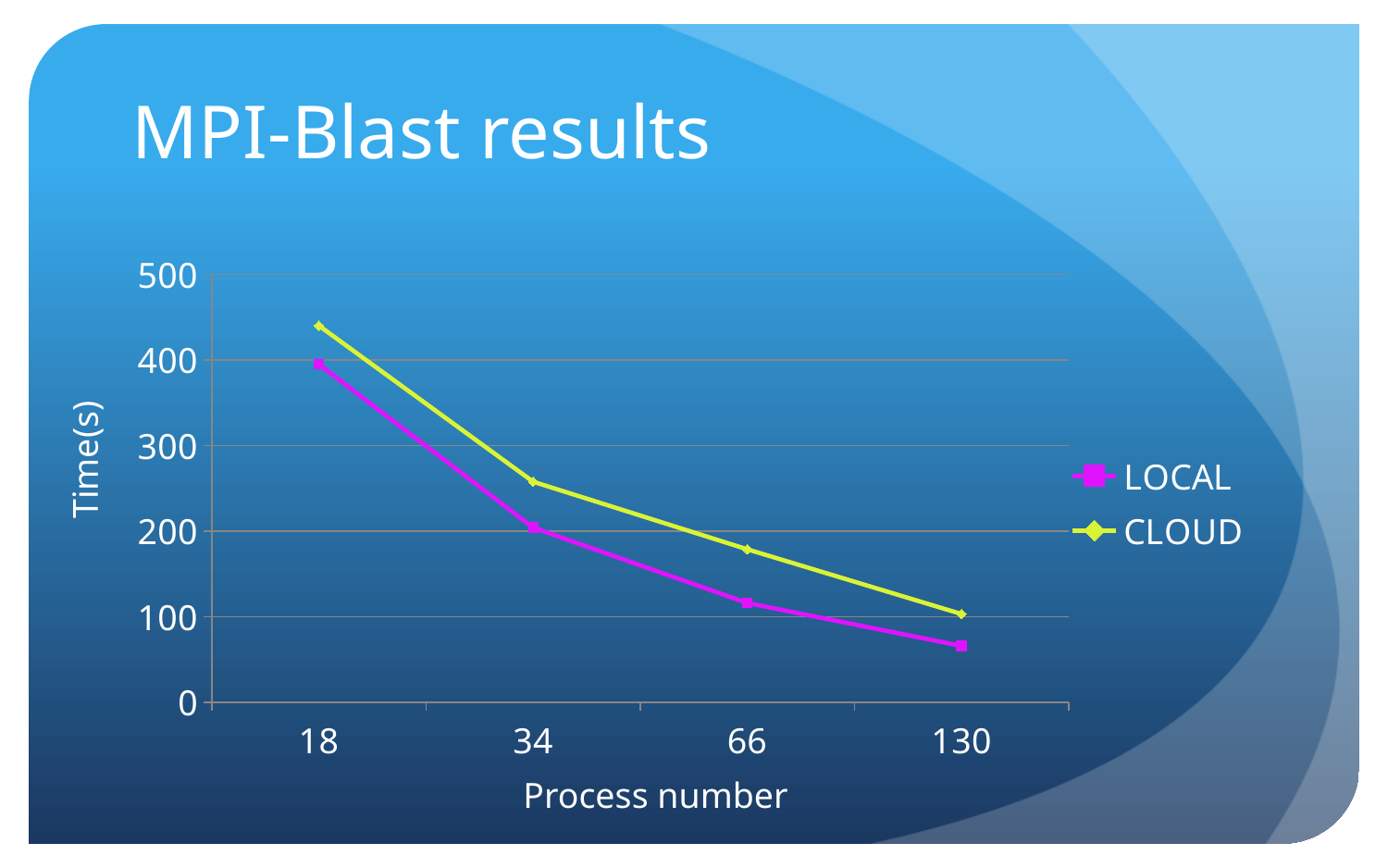
Is the CLOUD value at 18 processes greater or less than 400? greater At which process number is the CLOUD time lowest? 130 What kind of chart is shown on the slide? line chart Is the LOCAL value at 34 processes greater or less than 300? less How many series does the legend list? 2 What is the label of the y axis? Time(s) How many process-number points are plotted along the x axis? 4 Is the LOCAL value at 130 processes greater or less than 100? less Do the LOCAL values rise or fall as the process number increases? fall At which process number is the LOCAL time highest? 18 At 66 processes, which series has the larger time, LOCAL or CLOUD? CLOUD